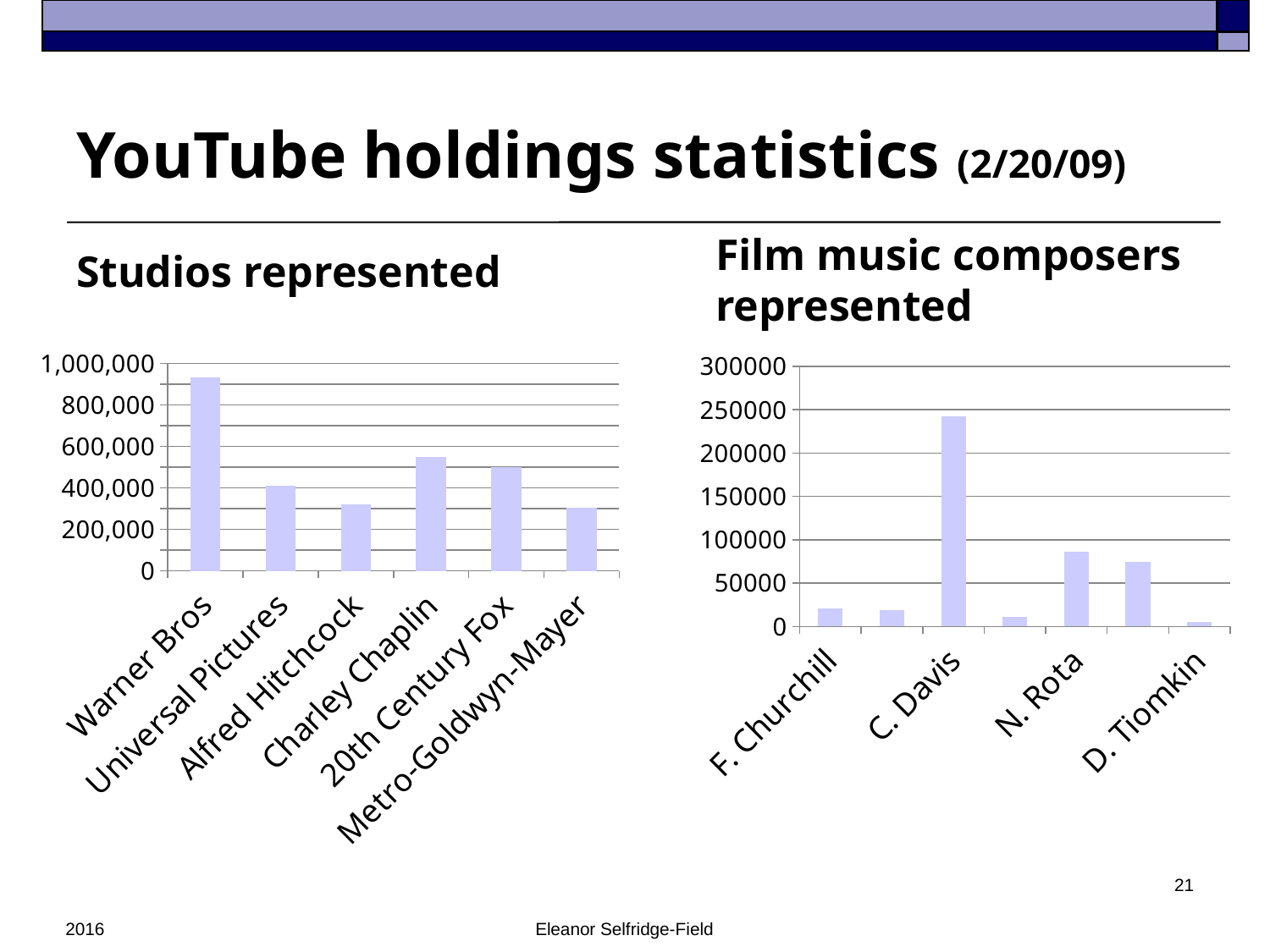
In the 'Film music composers represented' chart, is the value for C. Davis greater or less than 200000? greater In the 'Studios represented' chart, which studio has the highest value? Warner Bros What kind of chart is the 'Studios represented' chart? bar chart In the 'Film music composers represented' chart, which composer has the highest value? C. Davis In the 'Studios represented' chart, is the value for Metro-Goldwyn-Mayer greater or less than 400,000? less In the 'Film music composers represented' chart, is the value for N. Rota greater or less than 50000? greater In the 'Film music composers represented' chart, which is larger, the value for N. Rota or the value for F. Churchill? N. Rota In the 'Studios represented' chart, how many studios are plotted? 6 In the 'Studios represented' chart, which is larger, the value for Charley Chaplin or the value for 20th Century Fox? Charley Chaplin What is the title of the chart on the right side of the slide? Film music composers represented